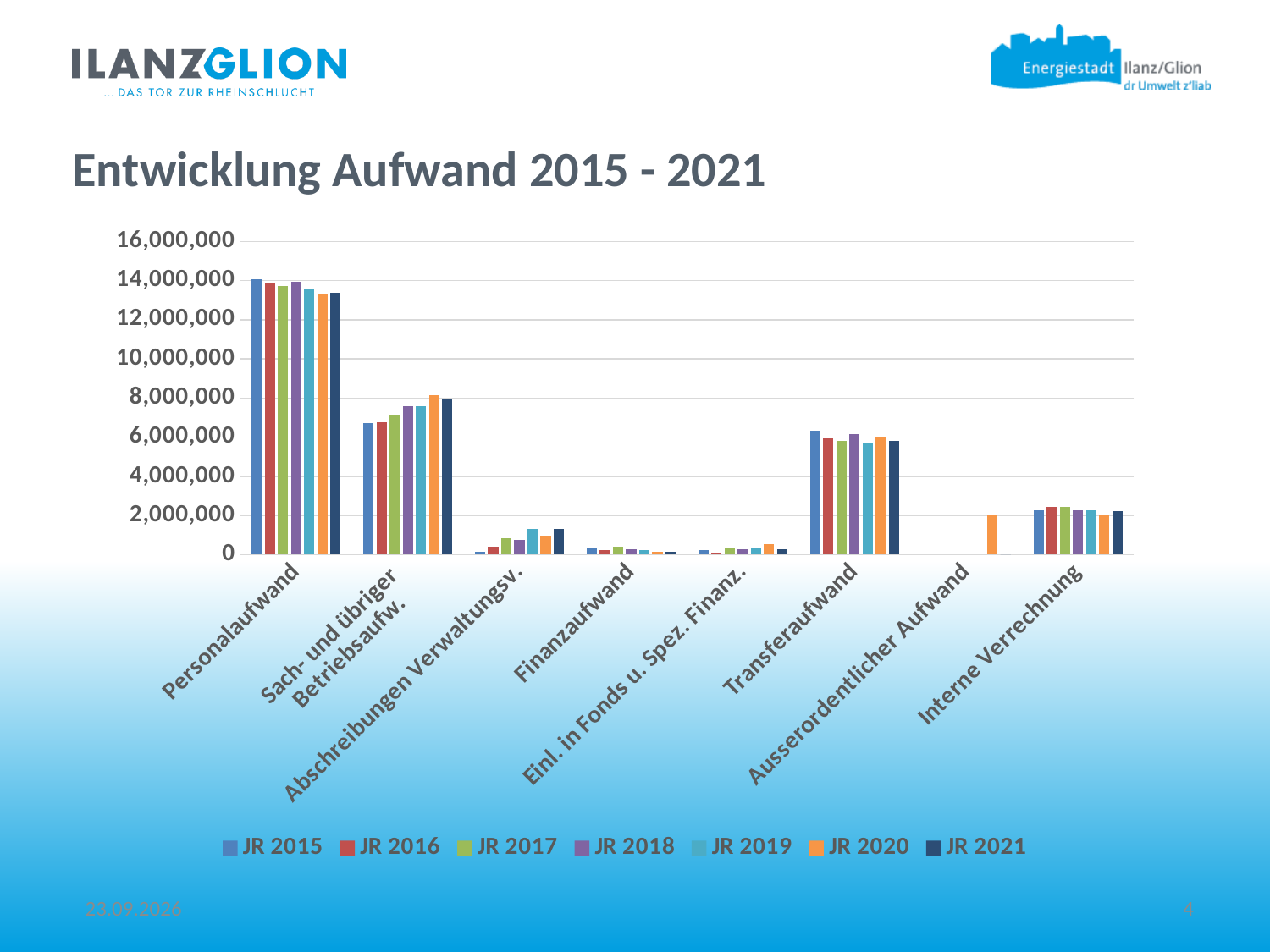
Is the value for Sach- und übriger Betriebsaufw. in JR 2020 greater or less than 6,000,000? greater What kind of chart is shown on the slide? bar chart Do the values for Sach- und übriger Betriebsaufw. generally rise or fall from JR 2015 to JR 2021? rise How many series does the legend list? 7 Is the value for Personalaufwand in JR 2015 greater or less than 12,000,000? greater Is the value for Transferaufwand in JR 2015 greater or less than 4,000,000? greater Which category has the highest bars overall? Personalaufwand How many categories are shown on the x axis? 8 For JR 2021, which is larger: Personalaufwand or Transferaufwand? Personalaufwand For Abschreibungen Verwaltungsv., which is larger: JR 2019 or JR 2020? JR 2019 What is the title of the chart? Entwicklung Aufwand 2015 - 2021